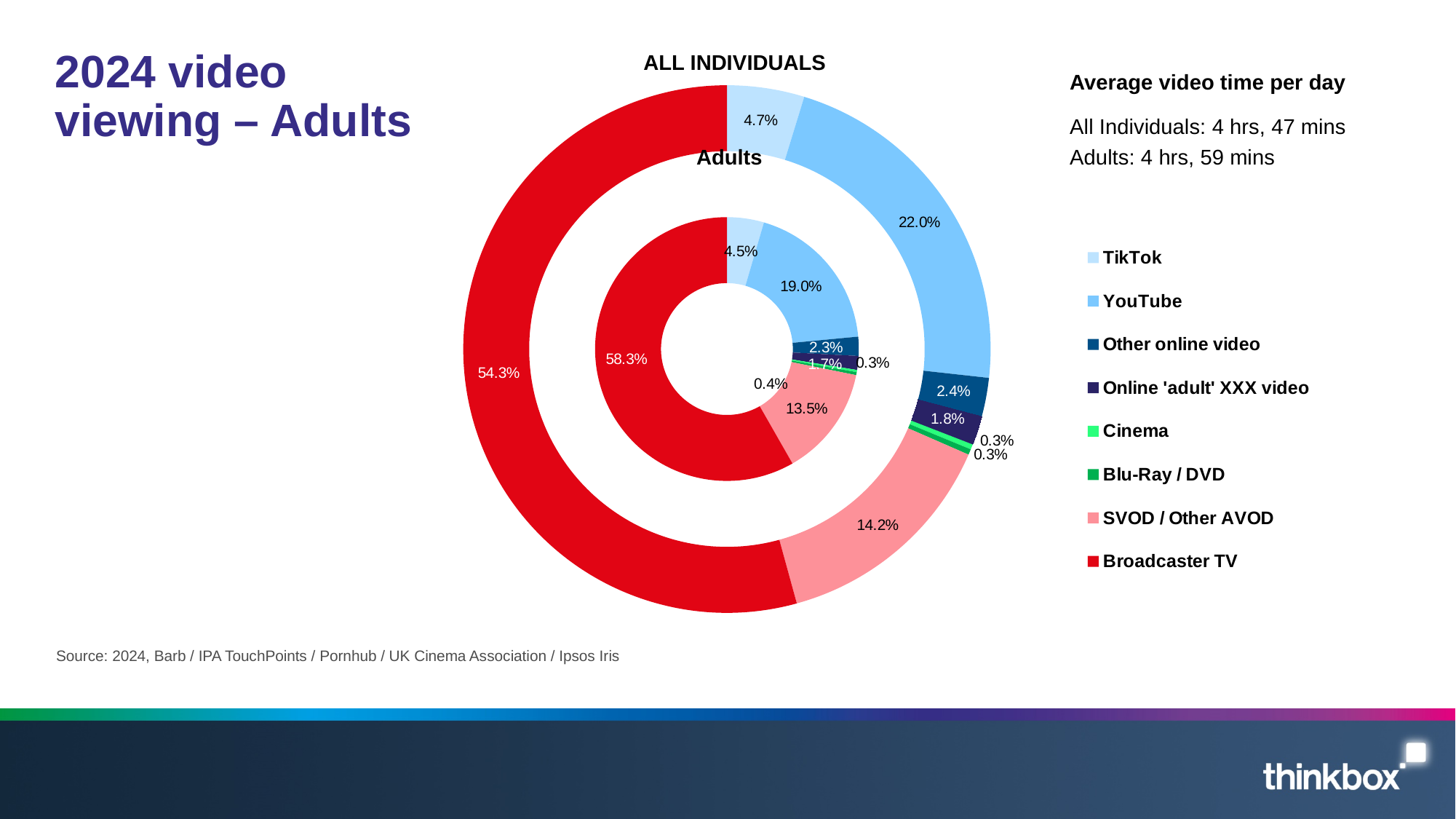
What is the difference between the Broadcaster TV share for Adults and for All Individuals? 4.0 percentage points How many categories does the legend list? 8 In the Adults ring, what is the share for TikTok? 4.5% According to the slide, what is the average video time per day for Adults? 4 hrs, 59 mins What kind of chart is shown on the slide? Doughnut chart In the ALL INDIVIDUALS ring, what is the share for SVOD / Other AVOD? 14.2% In the Adults ring, what is the share for YouTube? 19.0% In the ALL INDIVIDUALS ring, what is the share for YouTube? 22.0% In the Adults ring, what share of video time is Broadcaster TV? 58.3% Which is larger: the YouTube share for All Individuals or for Adults? All Individuals In the ALL INDIVIDUALS ring, what share of video time is Broadcaster TV? 54.3% Which category has the largest share in the ALL INDIVIDUALS ring? Broadcaster TV